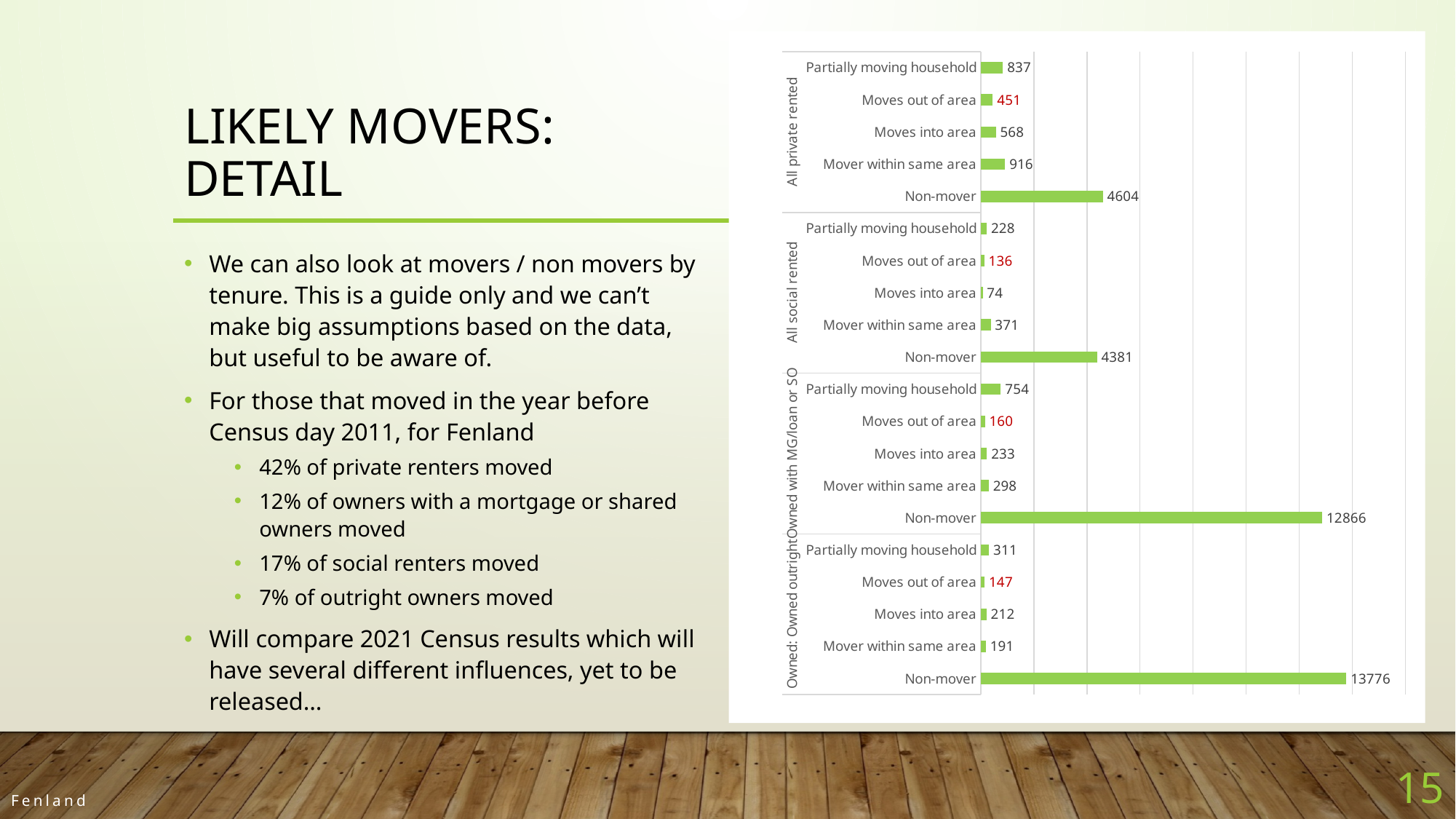
What is the value for Partially moving household in the Owned with MG/loan or SO group? 754 What is the difference between Non-mover in the Owned outright group and Non-mover in the Owned with MG/loan or SO group? 910 What is the value for Mover within same area in the Owned outright group? 191 How many bars are plotted on the chart in total? 20 What is the difference between Mover within same area and Moves into area in the All social rented group? 297 What kind of chart is shown on the slide? Bar chart Which bar has the lowest value on the chart? Moves into area (All social rented), 74 What is the value for Non-mover in the All private rented group? 4604 Which bar has the highest value on the chart? Non-mover (Owned outright), 13776 Which is larger: Moves into area in the All private rented group or Moves out of area in the All private rented group? Moves into area (568) Which values on the chart are shown in red data labels? Moves out of area What is the value for Moves out of area in the All social rented group? 136